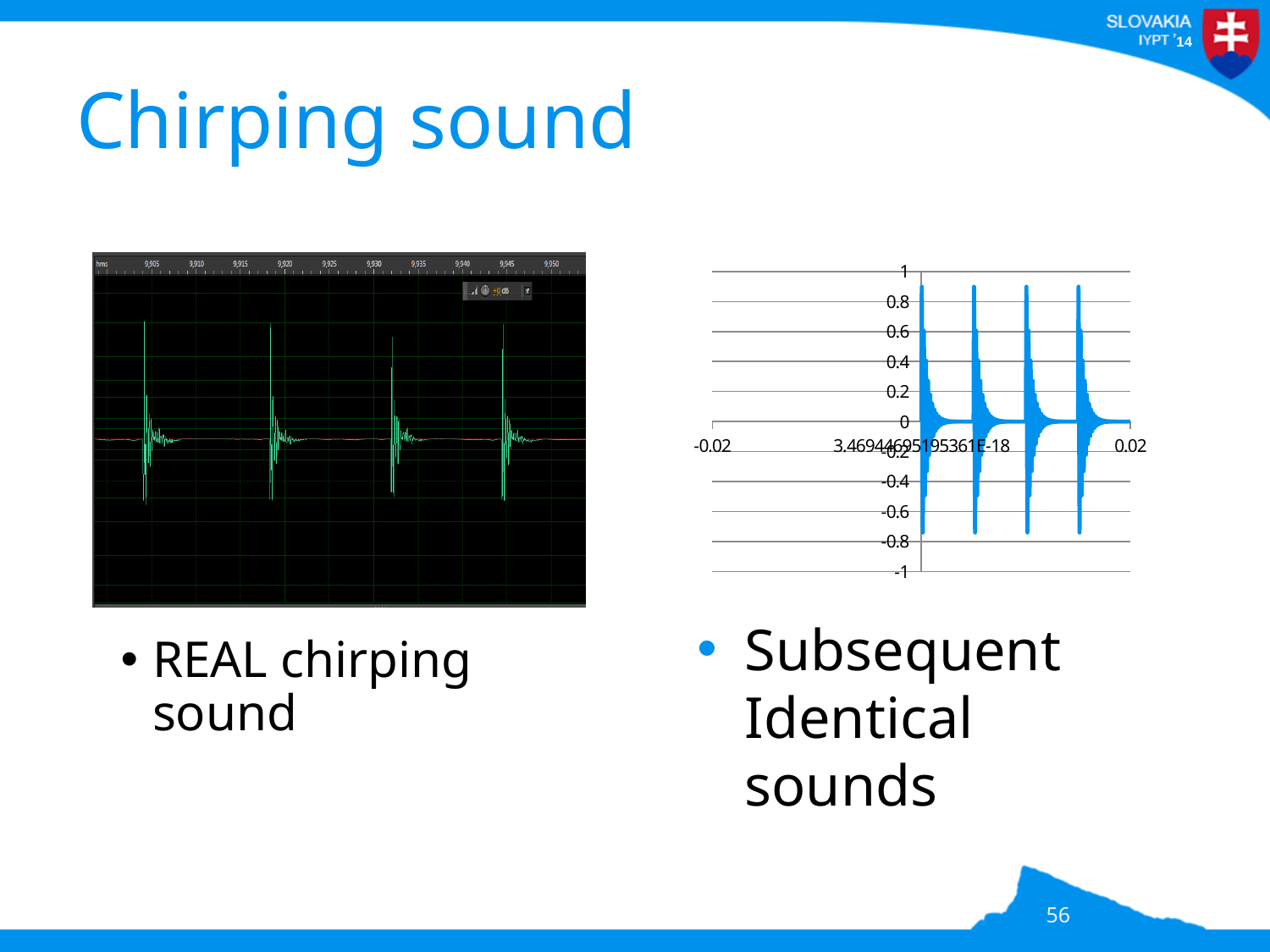
In the chart on the right, what is the rightmost value labelled on the horizontal axis? 0.02 In the waveform screenshot on the left, what is the first time label shown on the top ruler? 9,905 In the waveform screenshot on the left, what is the last time label shown on the top ruler? 9,950 In the chart on the right, how many separate sound bursts are plotted? 4 In the chart on the right, what is the leftmost value labelled on the horizontal axis? -0.02 In the chart on the right, is the lowest point of the first burst greater or less than -0.6? less In the chart on the right, what is the lowest value labelled on the vertical axis? -1 In the chart on the right, what is the highest value labelled on the vertical axis? 1 In the chart on the right, is the peak of the first burst greater or less than 0.6? greater In the waveform screenshot on the left, how many separate chirp bursts are visible? 4 What kind of chart is the chart on the right of the slide? line chart In the chart on the right, is the peak of the last burst greater or less than 0.4? greater